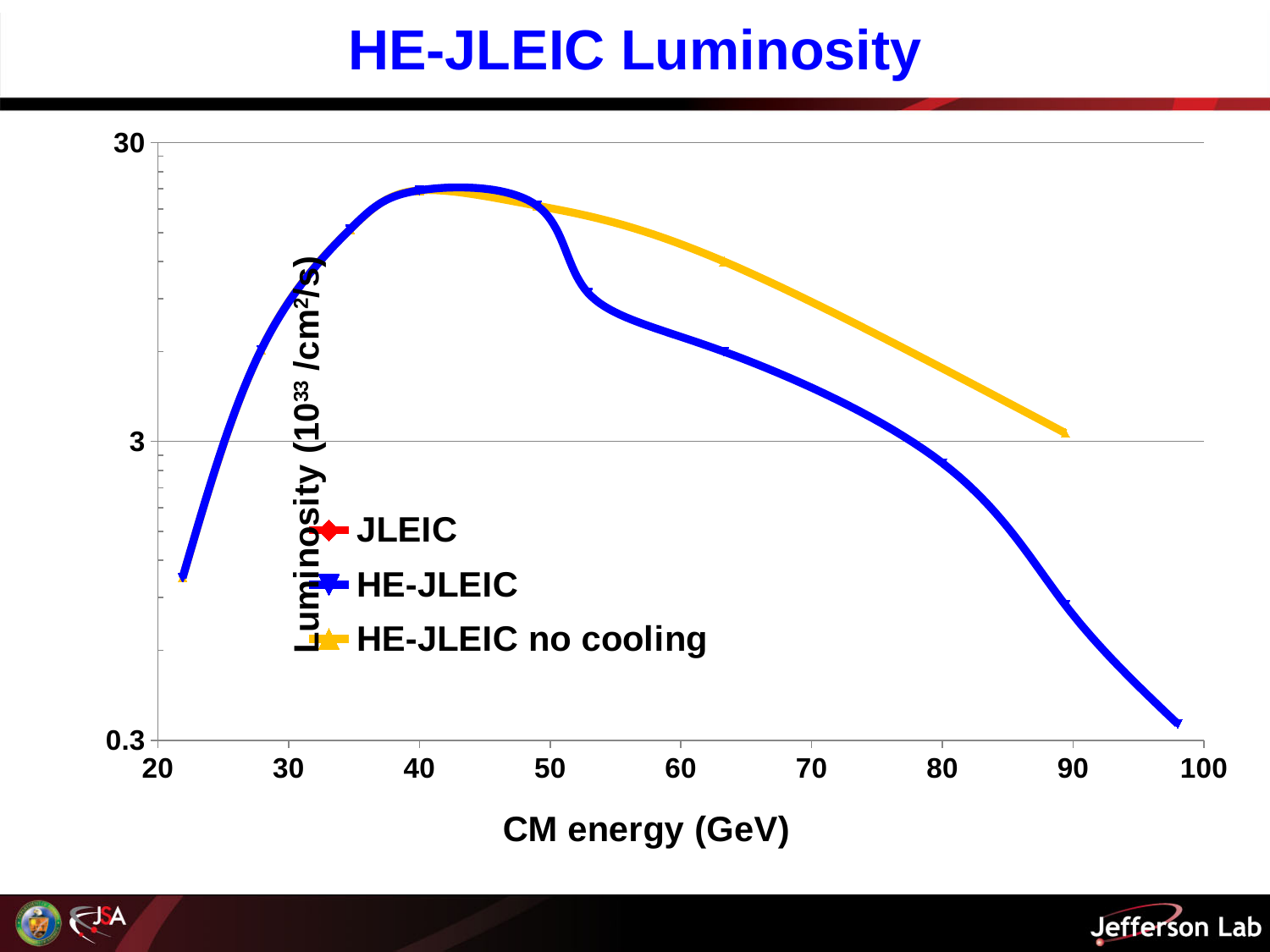
Is the HE-JLEIC luminosity at 40 GeV greater or less than 3? greater What is the label of the x axis? CM energy (GeV) Is the HE-JLEIC luminosity at about 22 GeV greater or less than 3? less How many series does the legend list? 3 What kind of chart is shown on the slide? line chart At 80 GeV, which series has the higher luminosity, HE-JLEIC or HE-JLEIC no cooling? HE-JLEIC no cooling Is the HE-JLEIC no cooling luminosity at 80 GeV greater or less than 3? greater What is the title of the chart? HE-JLEIC Luminosity Which series reaches the highest CM energy on the chart? HE-JLEIC Does the HE-JLEIC luminosity rise or fall as CM energy increases from 50 GeV to 100 GeV? fall Does the HE-JLEIC luminosity rise or fall as CM energy increases from 22 GeV to 40 GeV? rise